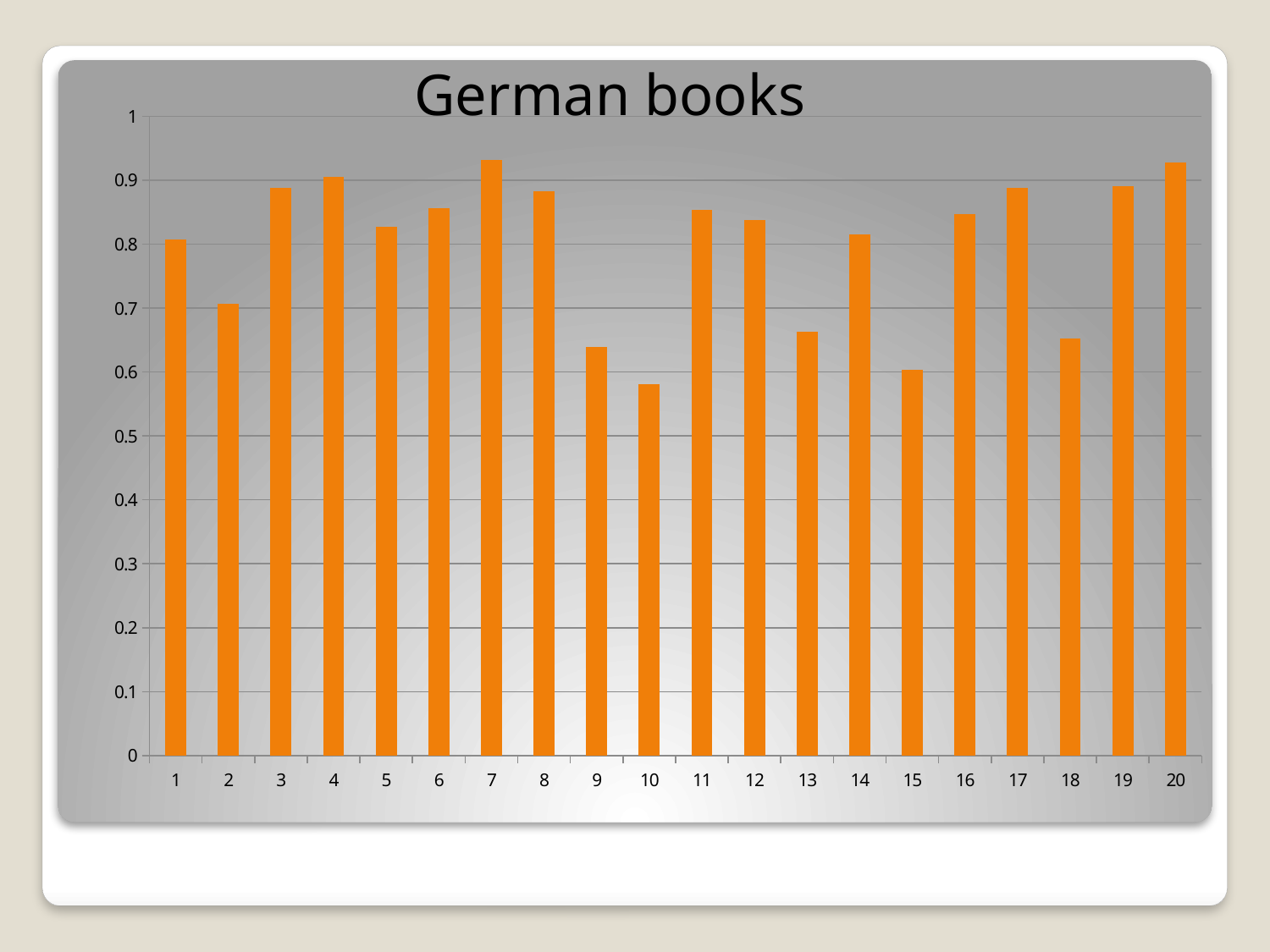
Which has the larger value, category 9 or category 10? 9 Is the value for category 7 greater or less than 0.9? greater Is the value for category 10 greater or less than 0.6? less What is the title of the chart? German books What kind of chart is shown on the slide? bar chart What colour are the bars in the chart? orange Is the value for category 9 greater or less than 0.6? greater How many bars are plotted in the chart? 20 Which has the larger value, category 2 or category 3? 3